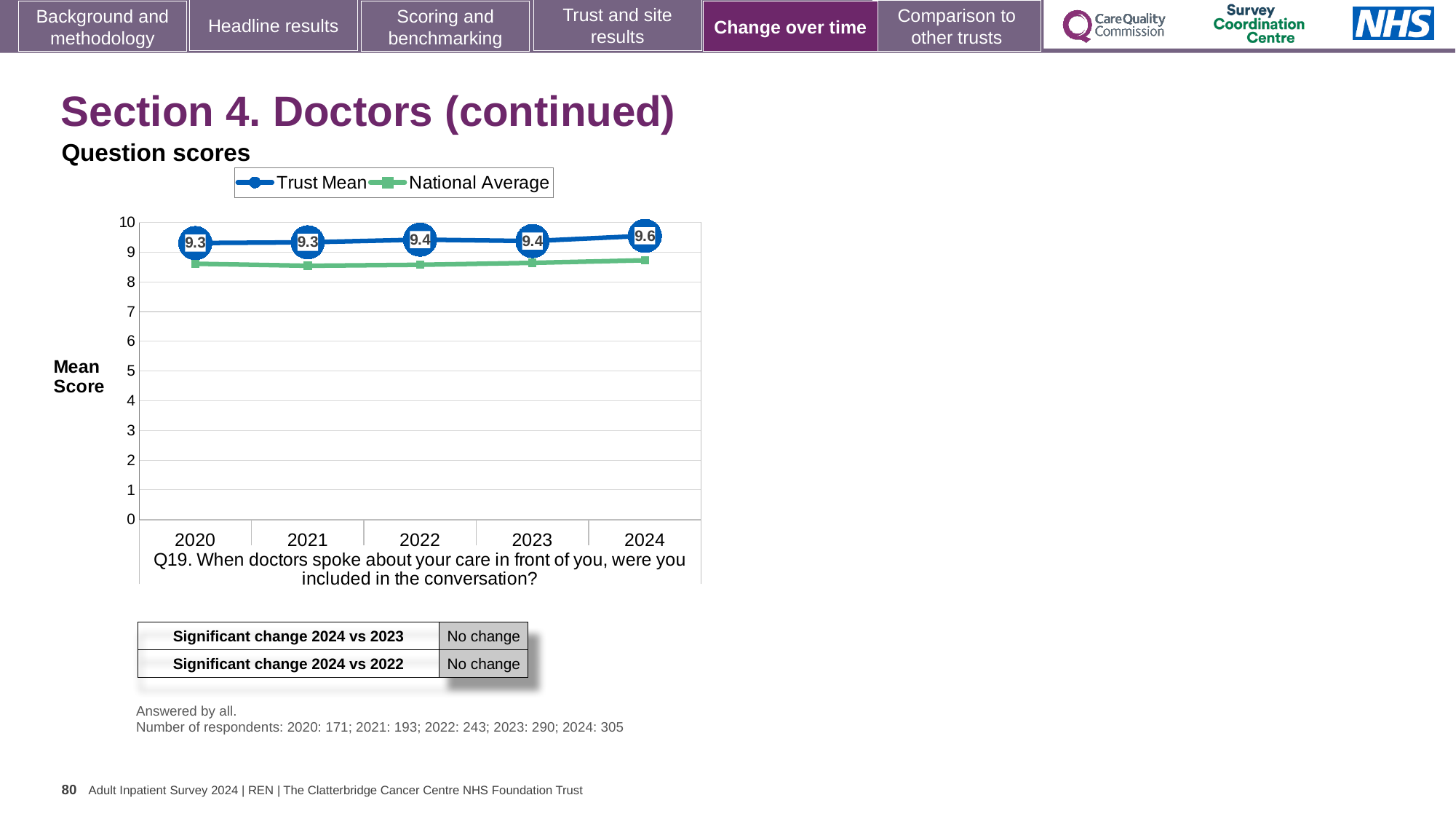
What is the Trust Mean value for 2020? 9.3 How many series does the legend list? 2 Does the Trust Mean rise or fall from 2020 to 2024? rise In which year is the Trust Mean highest? 2024 What is the Trust Mean value for 2022? 9.4 How many years are shown on the x axis? 5 What is the Trust Mean value for 2024? 9.6 What kind of chart is shown? line chart What is the difference between the Trust Mean in 2024 and in 2020? 0.3 Is the National Average value for 2021 greater or less than 9? less What is the difference between the Trust Mean in 2024 and in 2023? 0.2 Which is larger in 2024, the Trust Mean or the National Average? Trust Mean